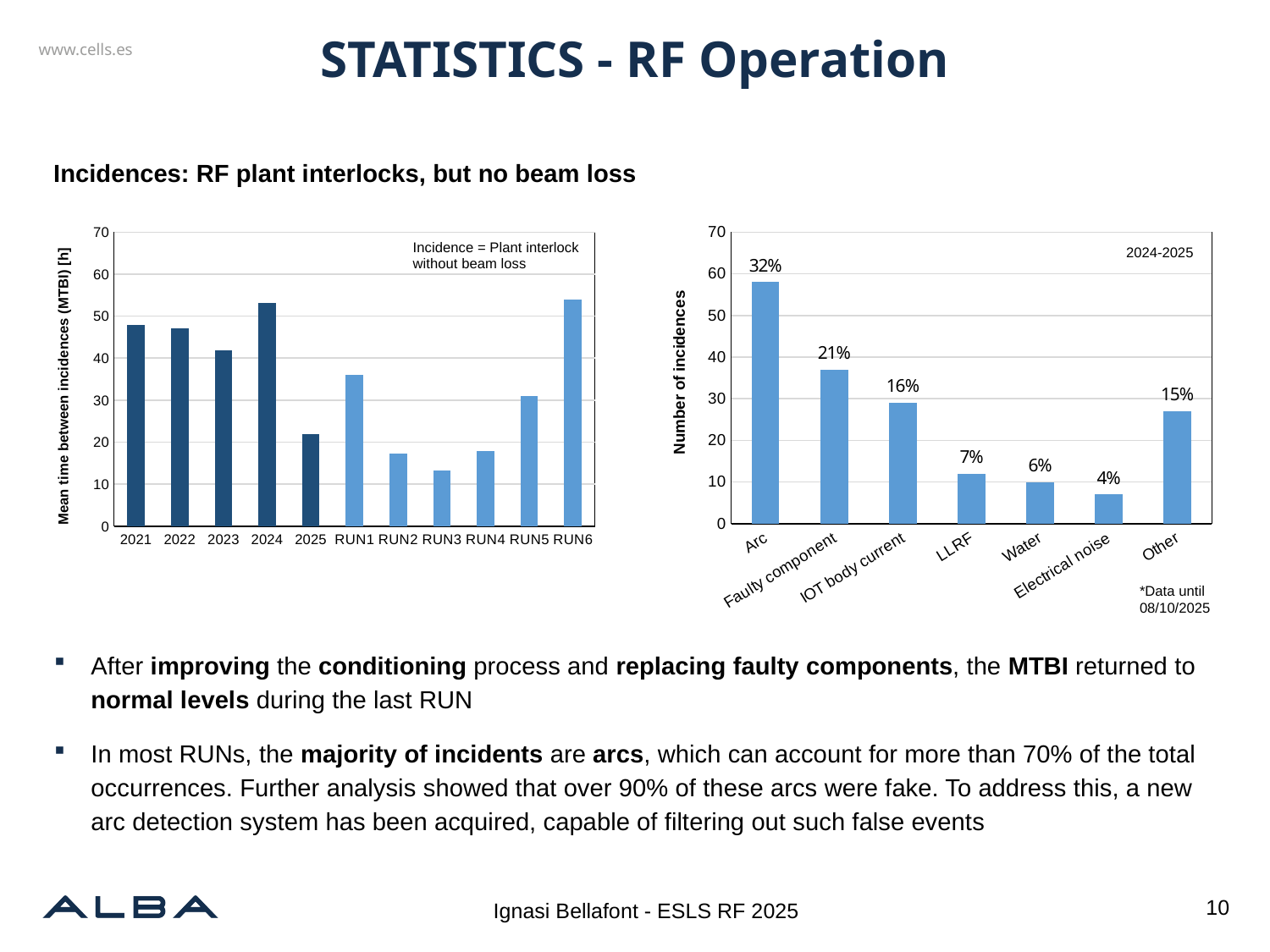
In the left chart (Mean time between incidences), is the value for 2021 greater or less than 40? greater In the right chart (Number of incidences), which category has the highest number of incidences? Arc What kind of chart is the left chart showing mean time between incidences? bar chart In the left chart (Mean time between incidences), is the value for RUN3 greater or less than 20? less In the left chart (Mean time between incidences), which has the higher value, 2024 or 2025? 2024 How many categories are shown on the x axis of the right chart (Number of incidences)? 7 In the right chart (Number of incidences), what percentage label is shown for Arc? 32% In the right chart (Number of incidences), which category has the lowest number of incidences? Electrical noise In the left chart (Mean time between incidences), is the value for RUN6 greater or less than 50? greater In the left chart (Mean time between incidences), which RUN has the lowest value? RUN3 In the right chart (Number of incidences), what is the difference in percentage points between the labels for Arc and Faulty component? 11% How many categories are shown on the x axis of the left chart (Mean time between incidences)? 11